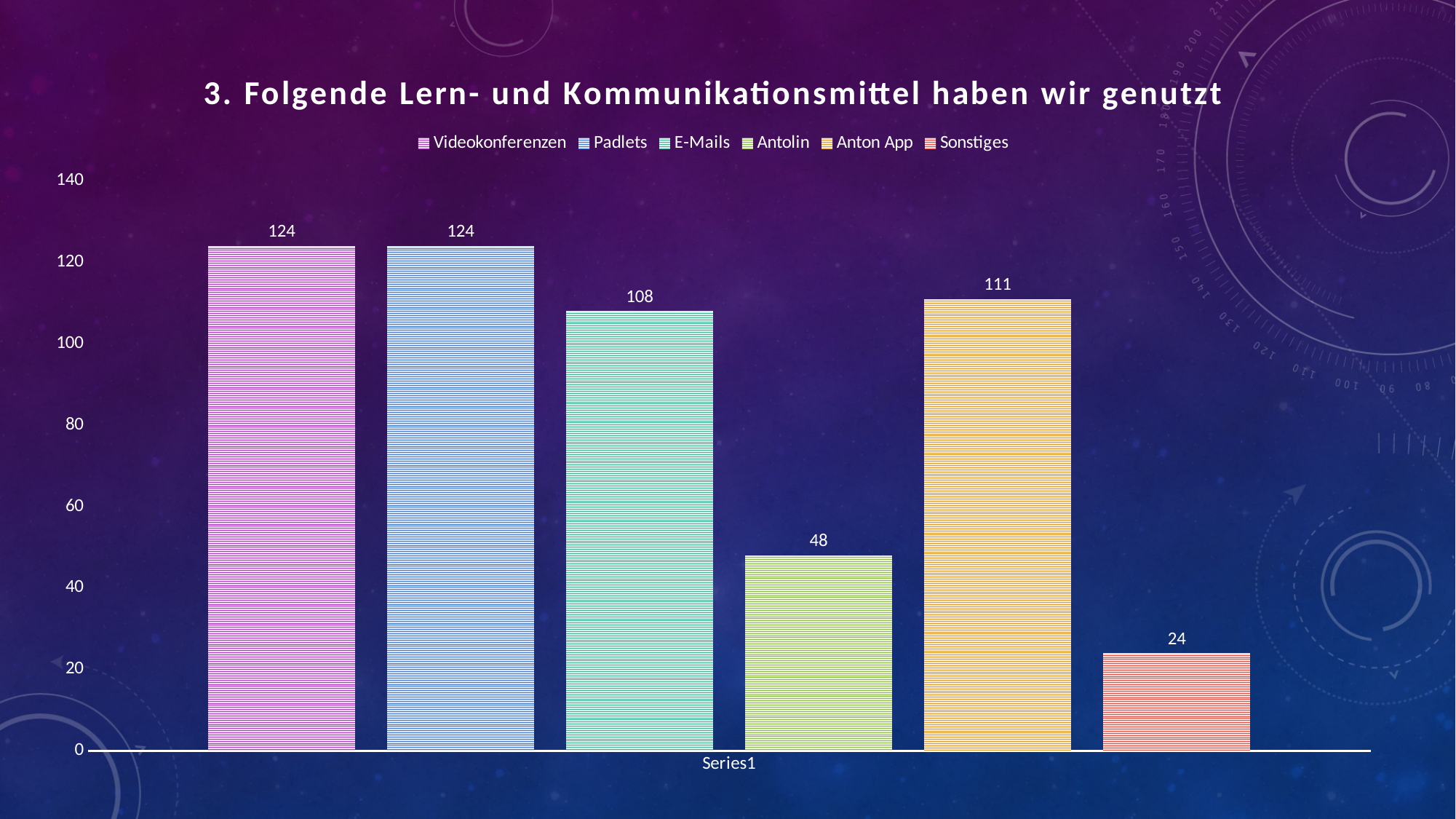
What value is shown for Anton App? 111 Which has a larger value, E-Mails or Anton App? Anton App What is the difference between the values for Anton App and E-Mails? 3 What value is shown for Videokonferenzen? 124 What value is shown for E-Mails? 108 Which learning or communication tool has the lowest value? Sonstiges How many series does the legend list? 6 What value is shown for Antolin? 48 Is the value for Antolin greater or less than 60? less What value is shown for Sonstiges? 24 What is the difference between the values for Padlets and Antolin? 76 What kind of chart is shown on the slide? bar chart